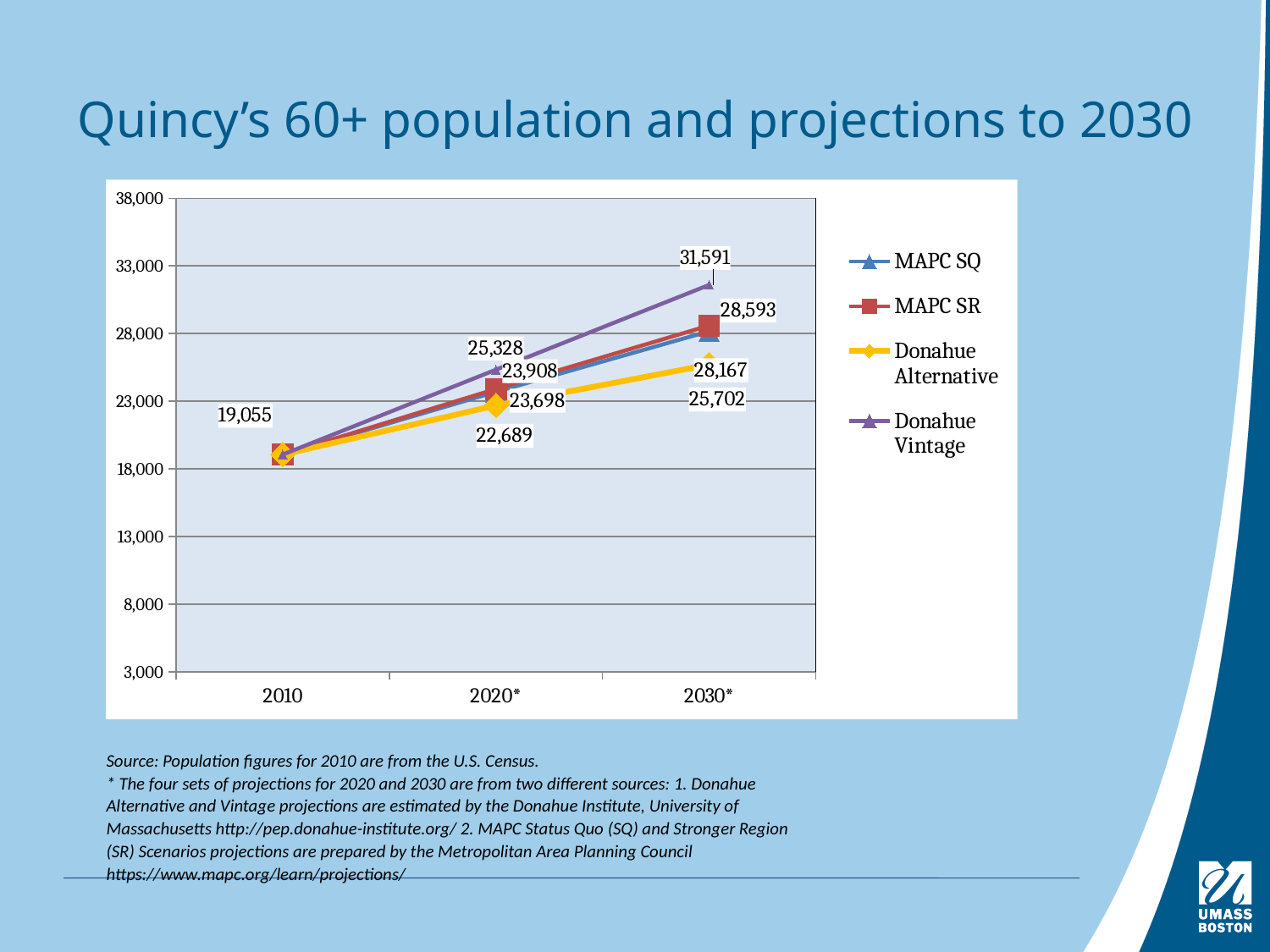
What is the Donahue Vintage projection for 2030*? 31,591 What is the difference between the Donahue Vintage and Donahue Alternative projections for 2030*? 5,889 What is the Donahue Alternative projection for 2030*? 25,702 How many points are shown along the x axis? 3 How many series does the legend list? 4 What is the title of the chart? Quincy's 60+ population and projections to 2030 What kind of chart is shown on the slide? line chart What is the Donahue Vintage projection for 2020*? 25,328 Do the projected values rise or fall from 2010 to 2030*? rise Which series has the lowest projected value for 2030*? Donahue Alternative Which series has the highest projected value for 2030*? Donahue Vintage What is the 60+ population value shown for 2010? 19,055